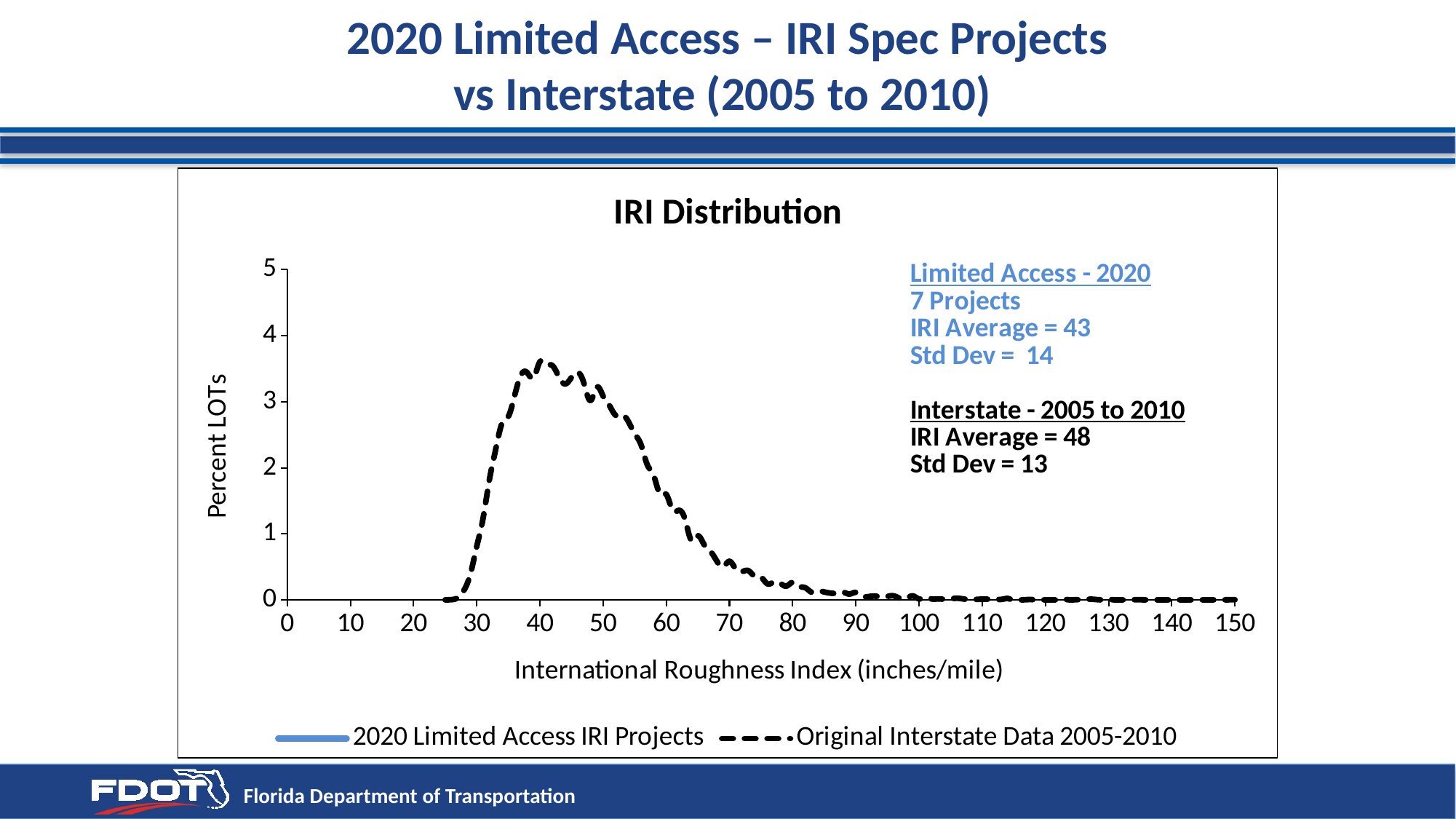
What kind of chart is shown on the slide? line chart How many series does the chart legend list? 2 According to the annotation on the chart, what is the IRI Average for Interstate - 2005 to 2010? 48 Is the Percent LOTs value of the Original Interstate Data 2005-2010 line at an IRI of 40 greater or less than 3? greater What is the title of the chart? IRI Distribution According to the annotation on the chart, what is the IRI Average for Limited Access - 2020? 43 For the Original Interstate Data 2005-2010 line, which IRI value has the higher Percent LOTs: 40 or 60? 40 What is the label of the x axis? International Roughness Index (inches/mile) Does the Original Interstate Data 2005-2010 line rise or fall as the IRI increases from 50 to 90? fall According to the annotation on the chart, what is the Std Dev for Interstate - 2005 to 2010? 13 How many projects are included in the Limited Access - 2020 data, according to the chart annotation? 7 Projects Is the Percent LOTs value of the Original Interstate Data 2005-2010 line at an IRI of 70 greater or less than 1? less